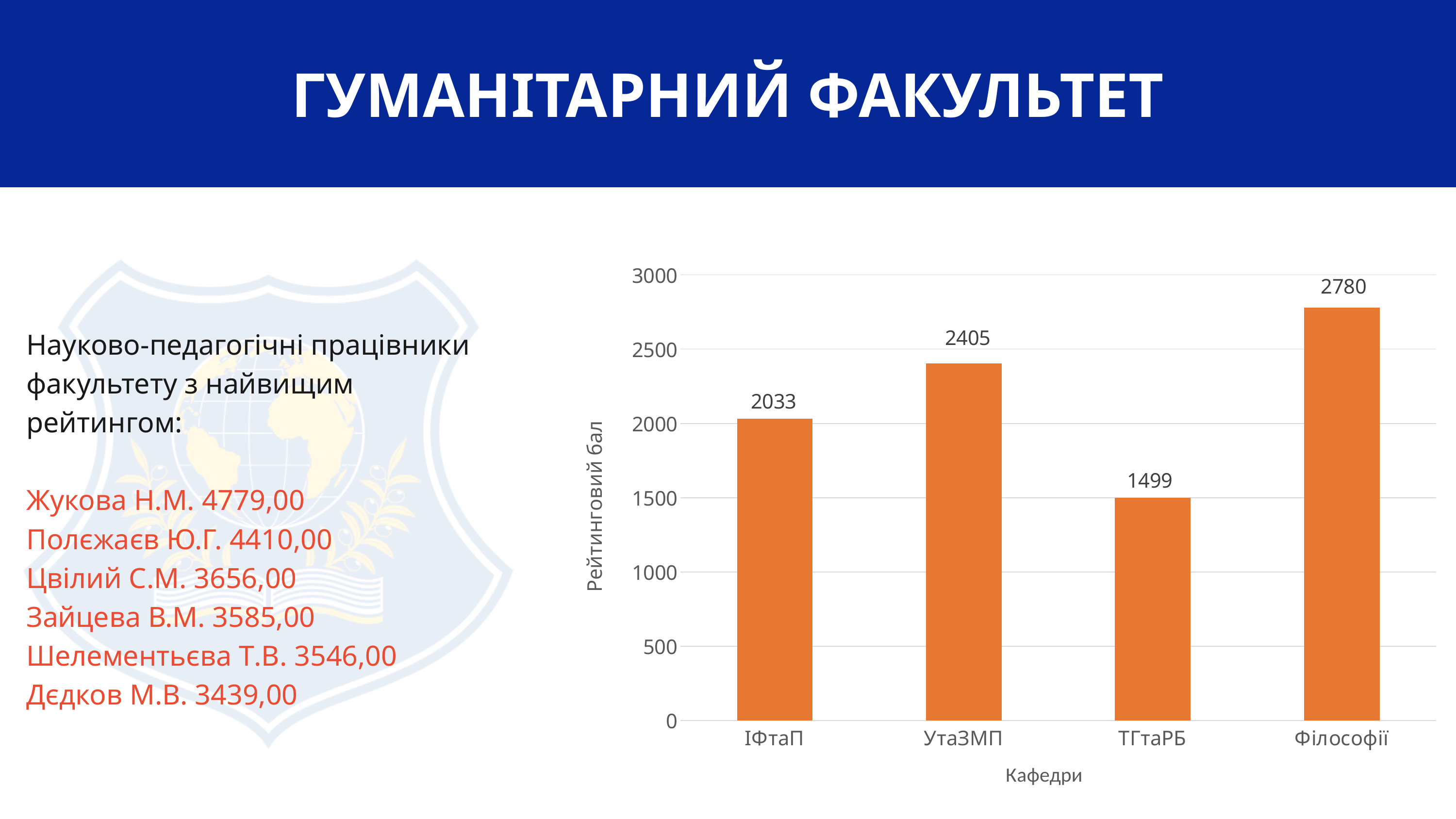
What is the label of the vertical axis of the chart? Рейтинговий бал Which department has the lowest rating score? ТГтаРБ What is the difference between the rating scores of Філософії and ТГтаРБ? 1281 Which department has a higher rating score, ІФтаП or УтаЗМП? УтаЗМП What is the difference between the rating scores of УтаЗМП and ІФтаП? 372 What is the rating score (Рейтинговий бал) for the ІФтаП department? 2033 What kind of chart is shown on the slide? Bar chart What is the rating score for the ТГтаРБ department? 1499 How many departments (Кафедри) are shown in the chart? 4 What is the rating score for the УтаЗМП department? 2405 Which department has the highest rating score? Філософії What is the rating score for the Філософії department? 2780